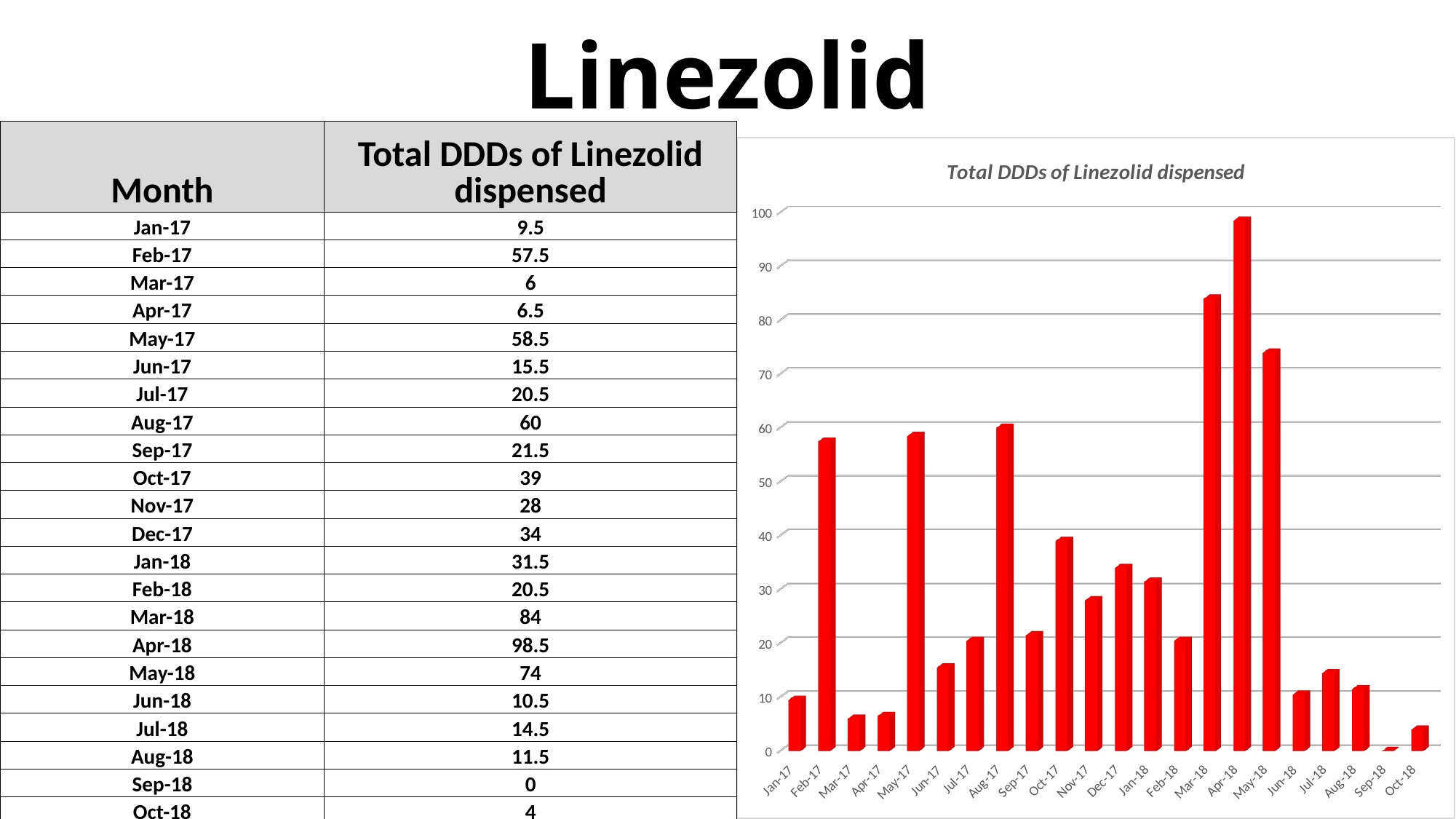
What colour are the bars in the chart? red Is the value for Mar-18 greater or less than 80? greater What is the total DDDs of Linezolid dispensed in Mar-18? 84 What is the total DDDs of Linezolid dispensed in Apr-18? 98.5 Which month has a higher value, Feb-17 or Aug-17? Aug-17 What is the title of the chart? Total DDDs of Linezolid dispensed What is the total DDDs of Linezolid dispensed in Oct-17? 39 Which month has the highest total DDDs of Linezolid dispensed? Apr-18 How many months are plotted in the chart? 22 What kind of chart is shown on the slide? bar chart What is the difference between the total DDDs dispensed in Apr-18 and May-18? 24.5 Which month has the lowest total DDDs of Linezolid dispensed? Sep-18